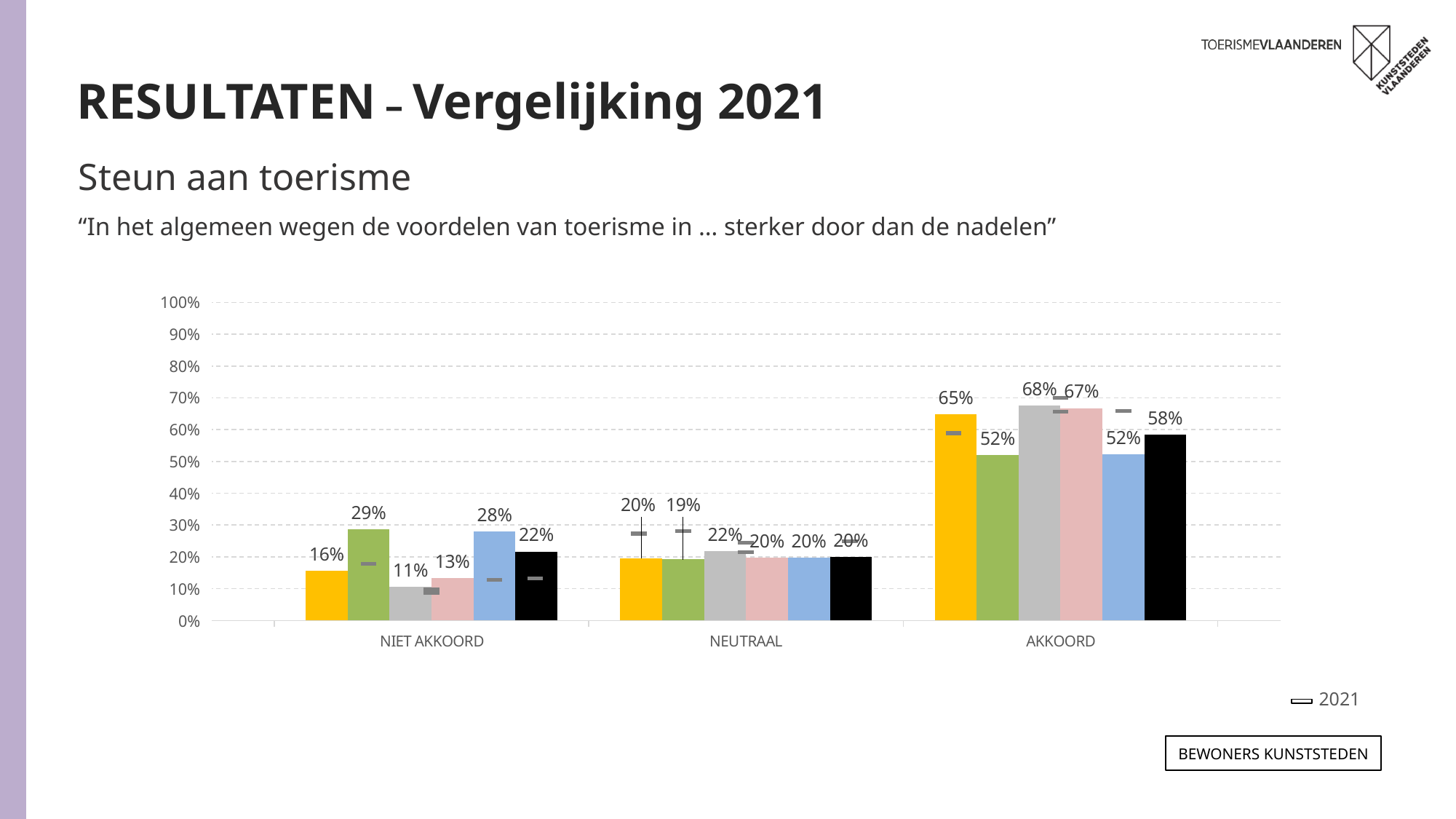
What is the value of the black bar for AKKOORD? 58% How many series does the chart's legend list? 1 Which coloured bar is the highest in the AKKOORD category? grey (68%) How many categories are shown on the x axis of the chart? 3 What is the value of the grey bar for NIET AKKOORD? 11% What is the value of the yellow bar for AKKOORD? 65% Which is larger: the green bar for NIET AKKOORD or the blue bar for NIET AKKOORD? green (29%) What kind of chart is shown on the slide? bar chart What is the difference between the grey bar for AKKOORD and the grey bar for NIET AKKOORD? 57 percentage points What label does the chart's legend show? 2021 What is the value of the green bar for NEUTRAAL? 19% Which coloured bar is the lowest in the NIET AKKOORD category? grey (11%)